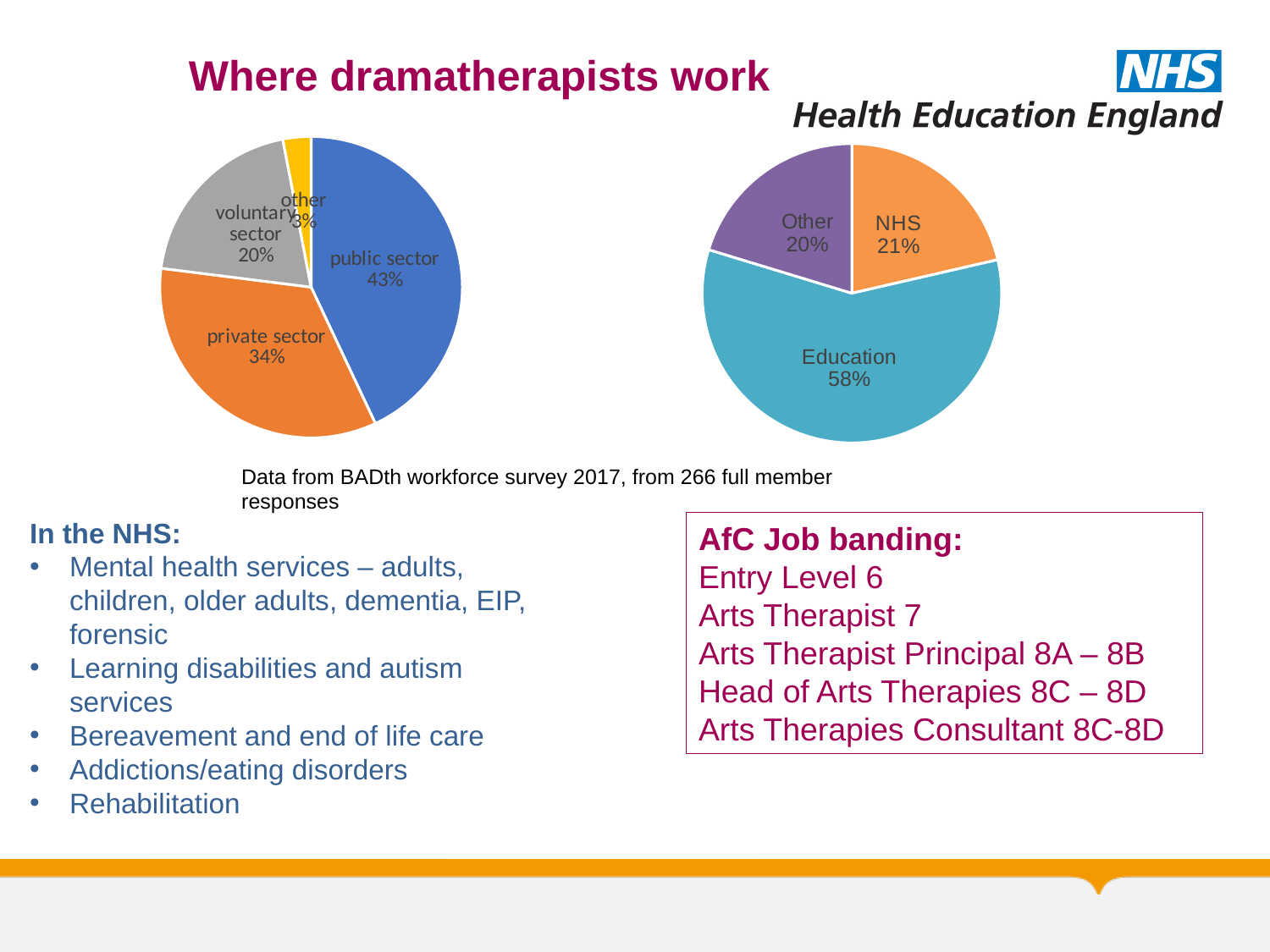
In the right pie chart, what is the difference between the Education share and the Other share? 38% In the left pie chart, what share of dramatherapists work in the public sector? 43% In the right pie chart, what share is labelled NHS? 21% In the right pie chart, which category has the largest share? Education How many slices does the left pie chart have? 4 In the left pie chart, which sector has the largest share? public sector In the left pie chart, which category has the smallest share? other In the left pie chart, what is the difference between the public sector and private sector shares? 9% In the right pie chart, what share is labelled Education? 58% What type of chart is used on this slide? pie chart In the left pie chart, what share is labelled voluntary sector? 20% In the left pie chart, what share of dramatherapists work in the private sector? 34%